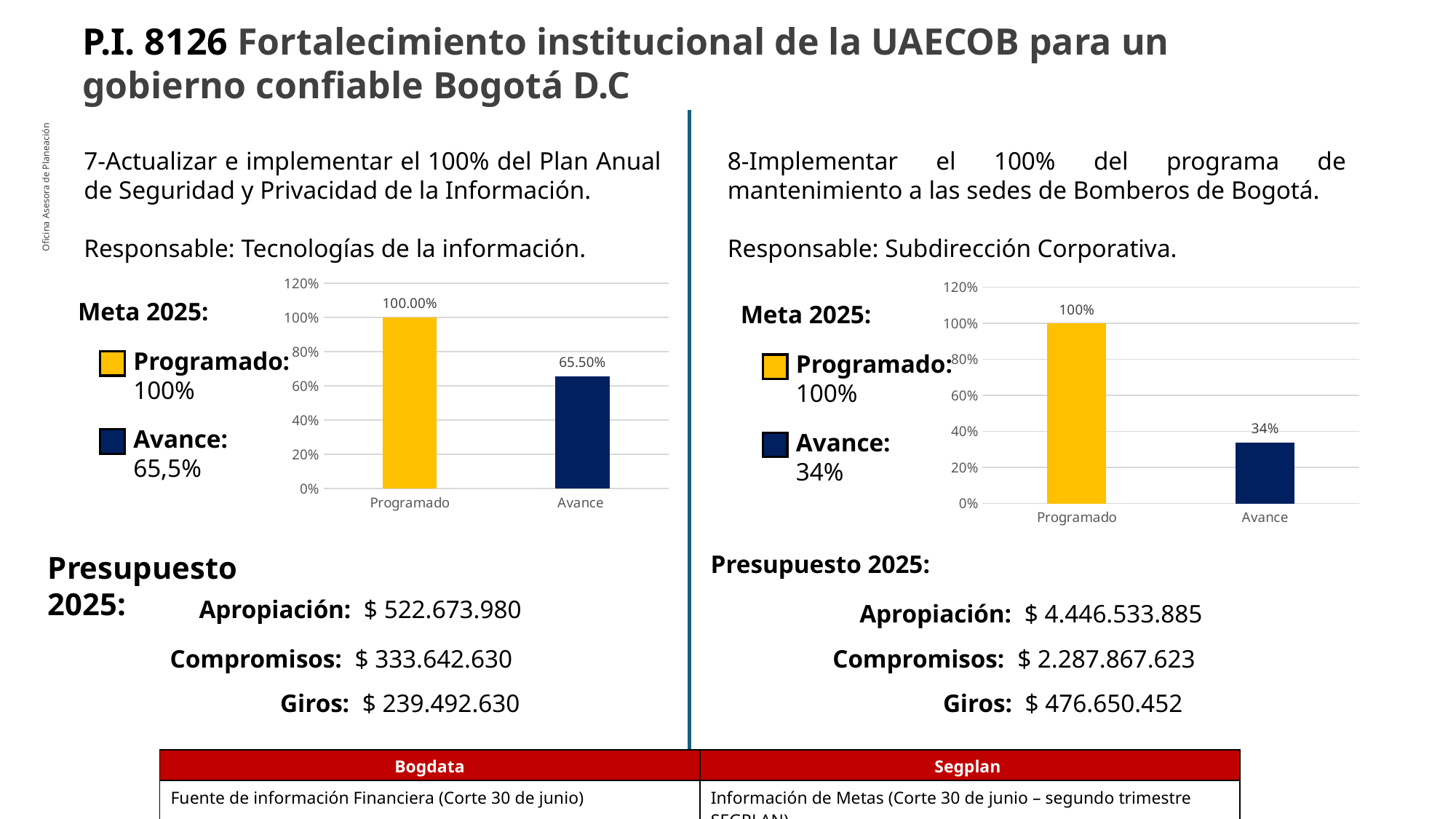
In the right chart, what is the difference between Programado and Avance? 66% In the left chart, what is the value for Avance? 65.50% In the right chart, what is the value for Avance? 34% In the right chart, is the value for Avance greater or less than 40%? less In the left chart, what is the value for Programado? 100.00% In the left chart, which category has the lowest value? Avance What type of chart is the right chart? bar chart In the left chart, what is the difference between Programado and Avance? 34.50% How many bars are shown in the left chart? 2 In the right chart, which category has the highest value? Programado In the left chart, what colour is the Avance bar? dark blue In the right chart, what is the value for Programado? 100%